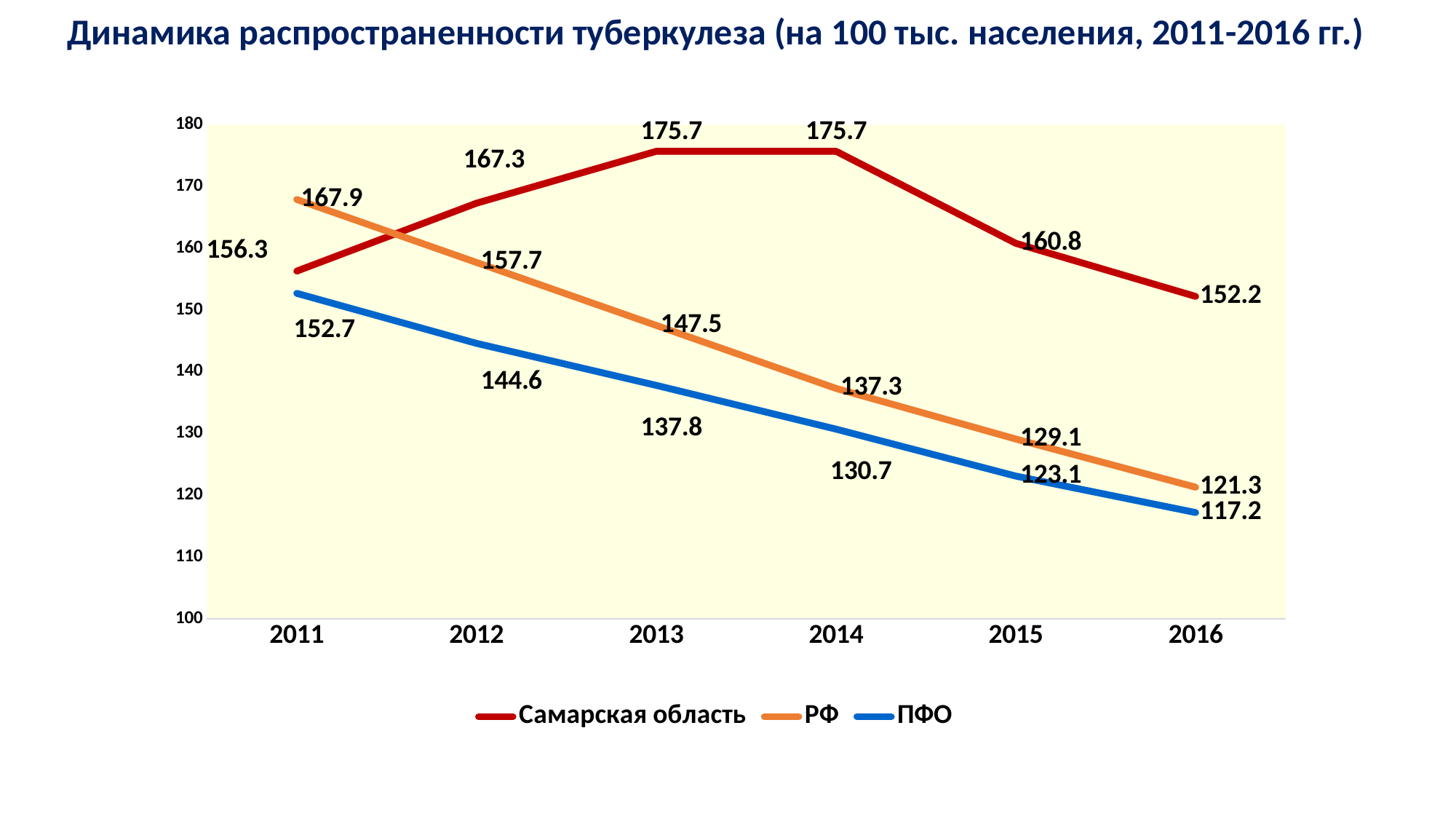
What is the value for Самарская область in 2013? 175.7 What is the value for ПФО in 2016? 117.2 How many series does the legend list? 3 Which is larger in 2011: the value for Самарская область or the value for РФ? РФ What colour is the line for Самарская область? red Which series has the highest value in 2016? Самарская область In which year is the value for РФ lowest? 2016 How many years are shown on the x axis? 6 What type of chart is shown on the slide? line chart What is the value for РФ in 2011? 167.9 What is the difference between the Самарская область and ПФО values in 2016? 35.0 Do the values for ПФО rise or fall from 2011 to 2016? fall